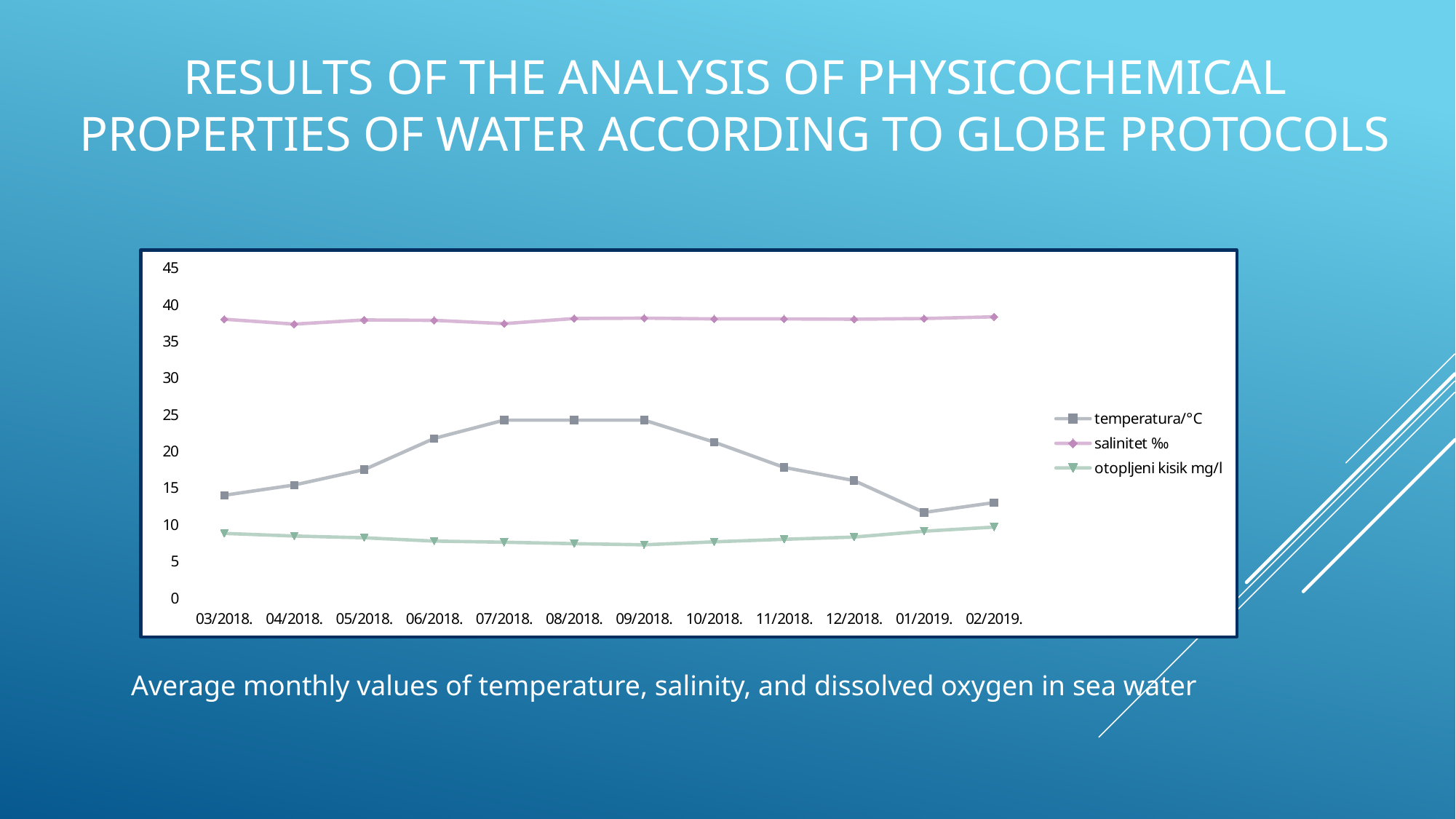
Is the value for temperatura/°C in 07/2018. greater or less than 20? greater Is the value for otopljeni kisik mg/l in 09/2018. greater or less than 10? less Is the value for temperatura/°C in 01/2019. greater or less than 15? less How many series does the legend list? 3 How many months are plotted along the x axis? 12 In 08/2018., which is larger: temperatura/°C or otopljeni kisik mg/l? temperatura/°C What kind of chart is shown on the slide? line chart Which series has the highest values throughout the whole period? salinitet ‰ Does temperatura/°C rise or fall from 09/2018. to 01/2019.? fall Does temperatura/°C rise or fall from 03/2018. to 07/2018.? rise In which month is temperatura/°C at its lowest? 01/2019.